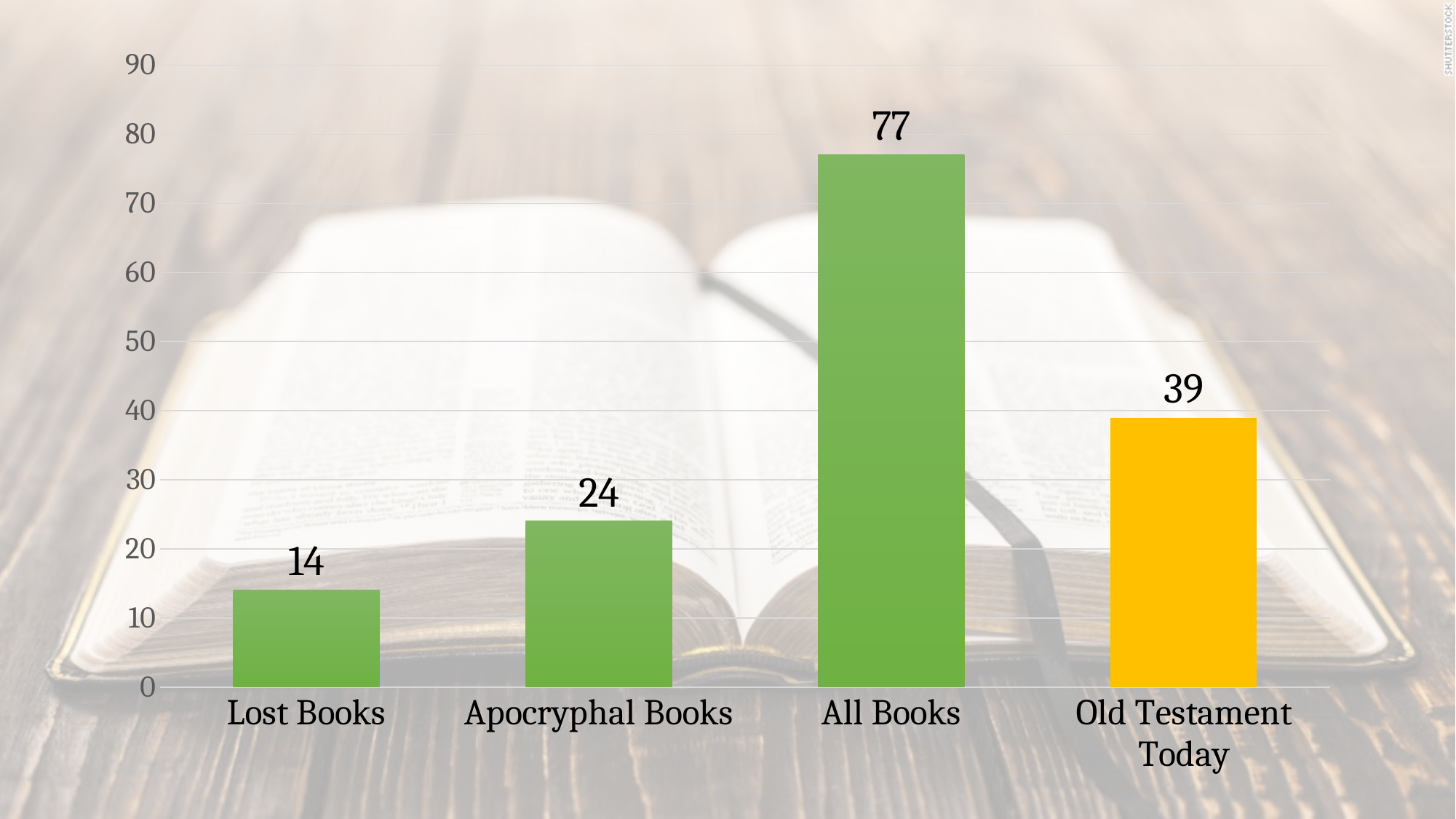
Which is larger, the value for Old Testament Today or the value for Apocryphal Books? Old Testament Today What kind of chart is shown on the slide? Bar chart Which category has the highest value? All Books How many categories are shown on the chart? 4 What is the value for Lost Books? 14 Which bar is coloured differently from the others? Old Testament Today What is the difference between the values for Apocryphal Books and Lost Books? 10 What is the value for Old Testament Today? 39 What is the difference between the values for All Books and Old Testament Today? 38 Which category has the lowest value? Lost Books What is the value for Apocryphal Books? 24 What is the value for All Books? 77